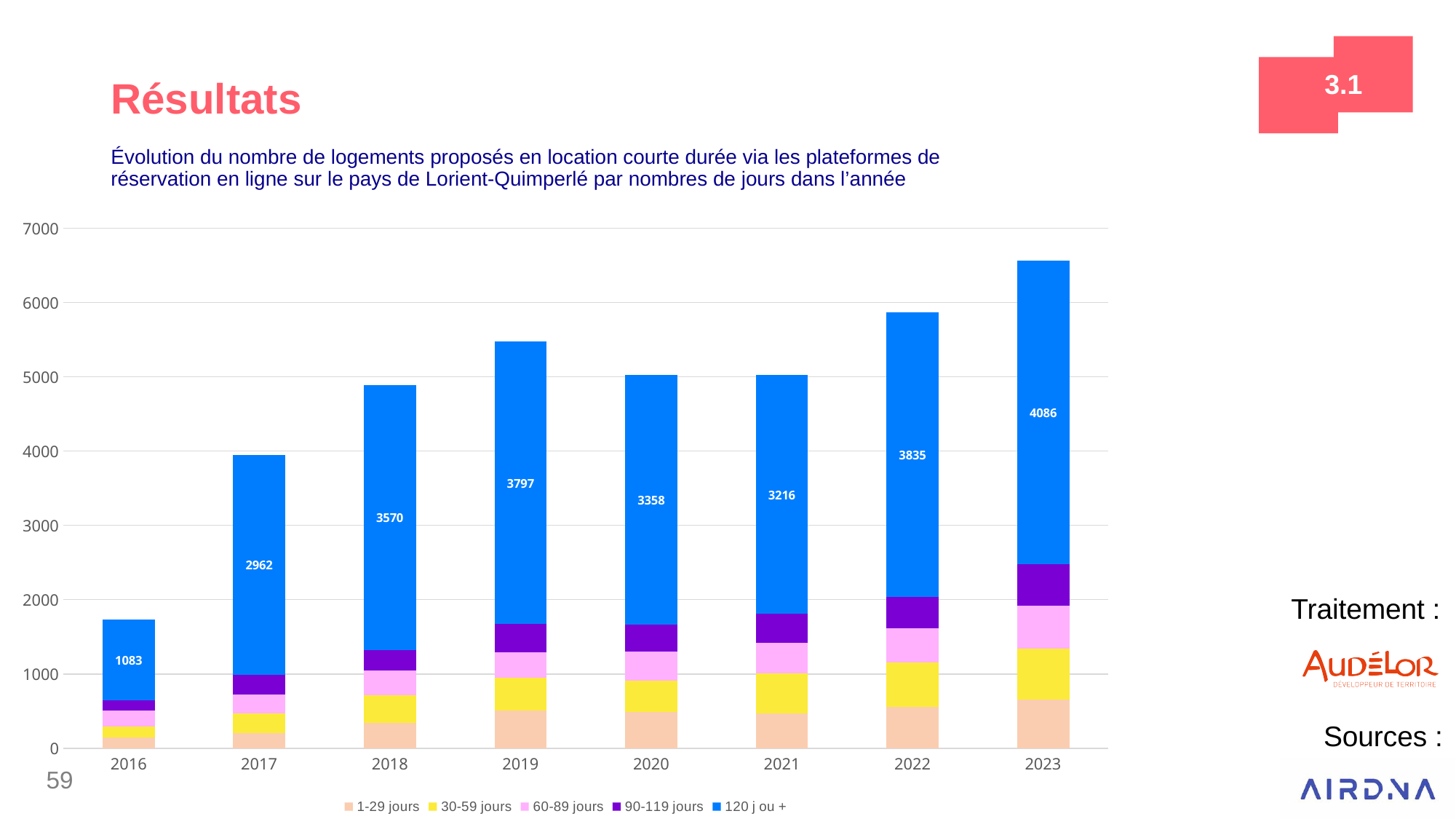
Is the total height of the 2016 bar greater or less than 2000? less Which year has the lowest value for the "120 j ou +" series? 2016 How many years are shown on the x axis? 8 What is the difference between the "120 j ou +" values for 2023 and 2022? 251 What kind of chart is shown on the slide? Stacked bar chart Is the total height of the 2023 bar greater or less than 6000? greater What is the value of the "120 j ou +" segment for 2016? 1083 How many series does the legend list? 5 Which year has the highest value for the "120 j ou +" series? 2023 Which year has the larger "120 j ou +" value, 2019 or 2020? 2019 What is the value of the "120 j ou +" segment for 2023? 4086 What is the value of the "120 j ou +" segment for 2019? 3797